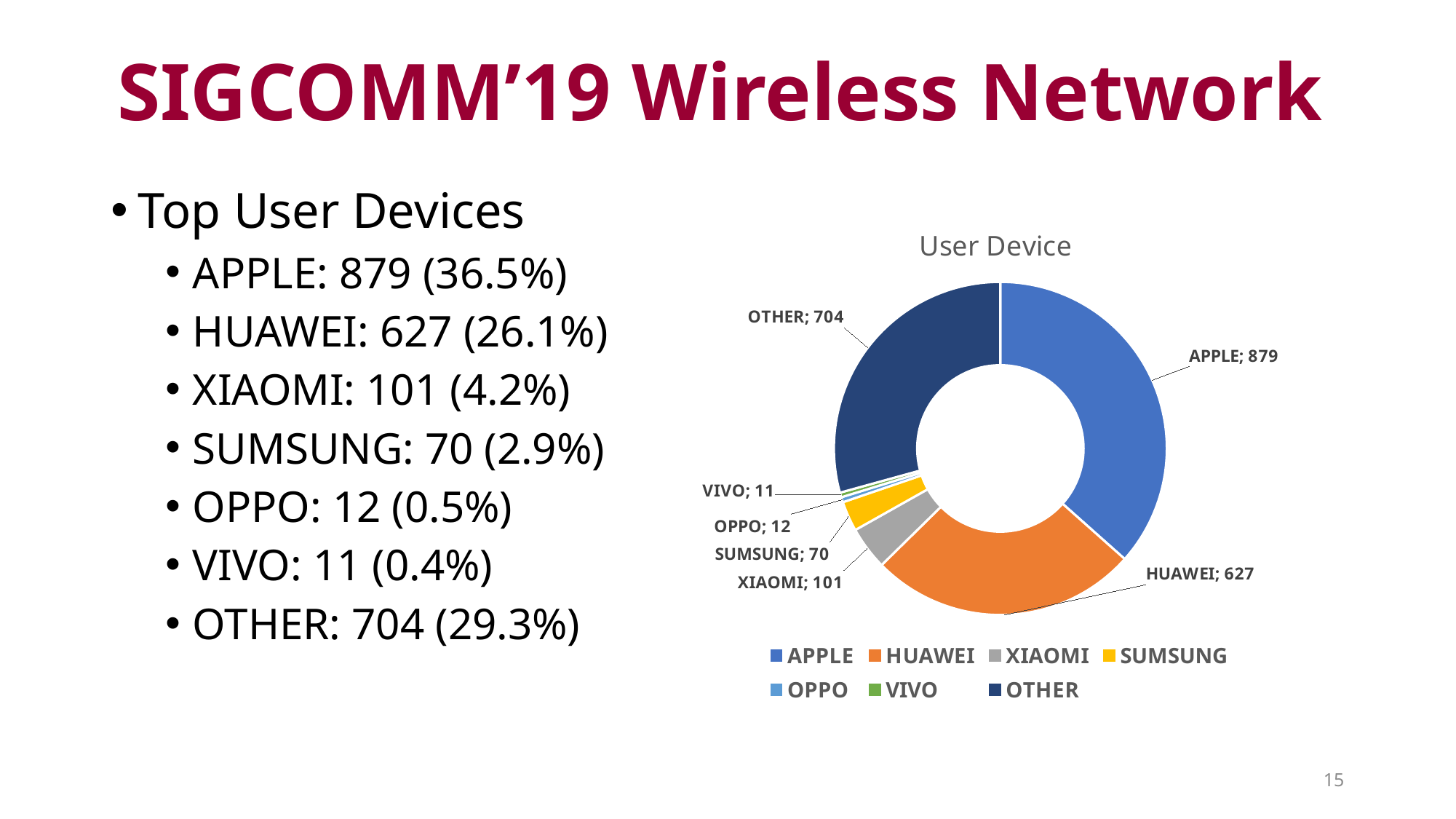
What is the difference between the APPLE and HUAWEI values in the User Device chart? 252 Which category has the lowest value in the User Device chart? VIVO How many categories are shown in the User Device chart? 7 Which is larger in the User Device chart, OTHER or HUAWEI? OTHER What is the value for OTHER in the User Device chart? 704 What is the value for APPLE in the User Device chart? 879 What is the value for HUAWEI in the User Device chart? 627 What share of the User Device chart does APPLE represent? 36.5% Which category has the highest value in the User Device chart? APPLE What kind of chart is the User Device chart? doughnut chart What is the value for SUMSUNG in the User Device chart? 70 What is the title of the chart on the slide? User Device